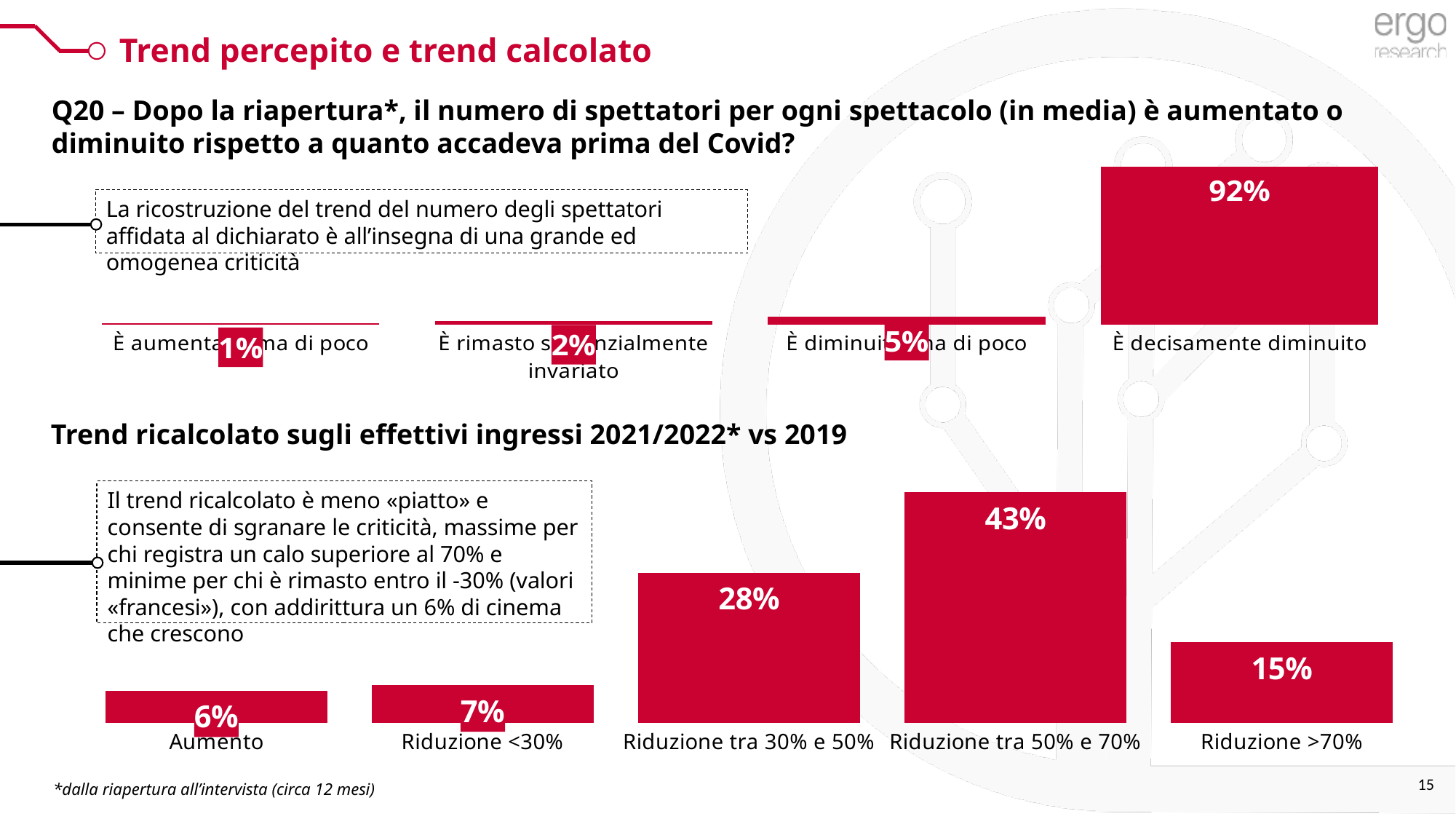
What type of chart is the bottom chart (Trend ricalcolato)? Bar chart In the bottom chart (Trend ricalcolato), how many categories are shown? 5 In the bottom chart (Trend ricalcolato), what is the value for "Riduzione tra 50% e 70%"? 43% In the bottom chart (Trend ricalcolato), what is the value for "Aumento"? 6% In the top chart (Q20), what is the difference between "È decisamente diminuito" and "È diminuito ma di poco"? 87% In the bottom chart (Trend ricalcolato), which is larger: "Riduzione tra 30% e 50%" or "Riduzione >70%"? Riduzione tra 30% e 50% In the top chart (Q20), what percentage of respondents answered "È decisamente diminuito"? 92% In the bottom chart (Trend ricalcolato), which category has the highest value? Riduzione tra 50% e 70% In the top chart (Q20), what is the value for "È diminuito ma di poco"? 5% In the top chart (Q20), which category has the highest value? È decisamente diminuito In the top chart (Q20), which category has the lowest value? È aumentato ma di poco In the top chart (Q20), how many categories are shown? 4